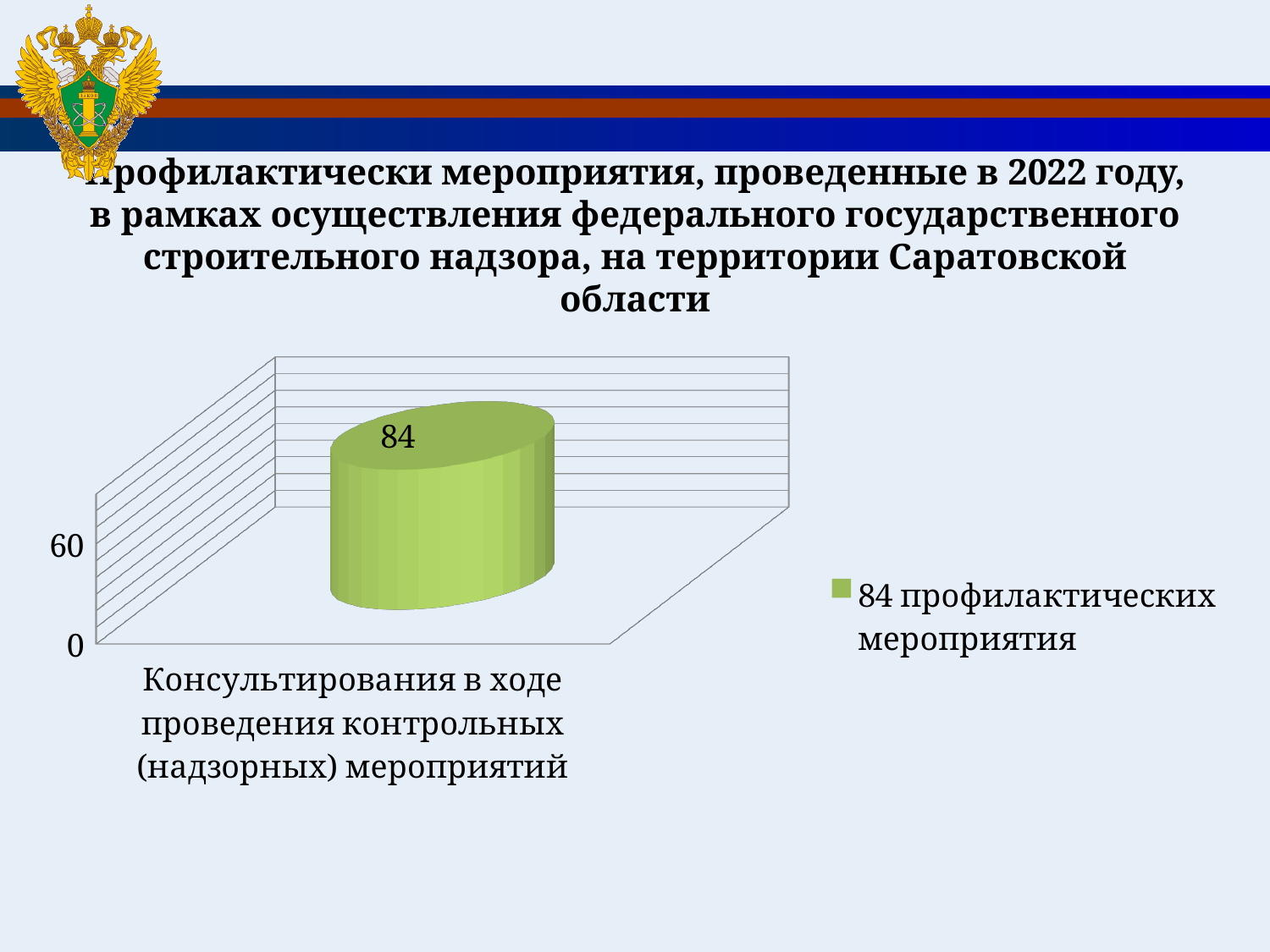
What is the legend entry for the series shown on the chart? 84 профилактических мероприятия Is the value for "Консультирования в ходе проведения контрольных (надзорных) мероприятий" greater or less than 60? greater What is the highest value printed on the chart? 84 What colour is the bar on the chart? green What kind of chart is shown on the slide? bar chart What is the value shown for the category "Консультирования в ходе проведения контрольных (надзорных) мероприятий"? 84 How many categories are plotted on the chart? 1 How many series does the legend list? 1